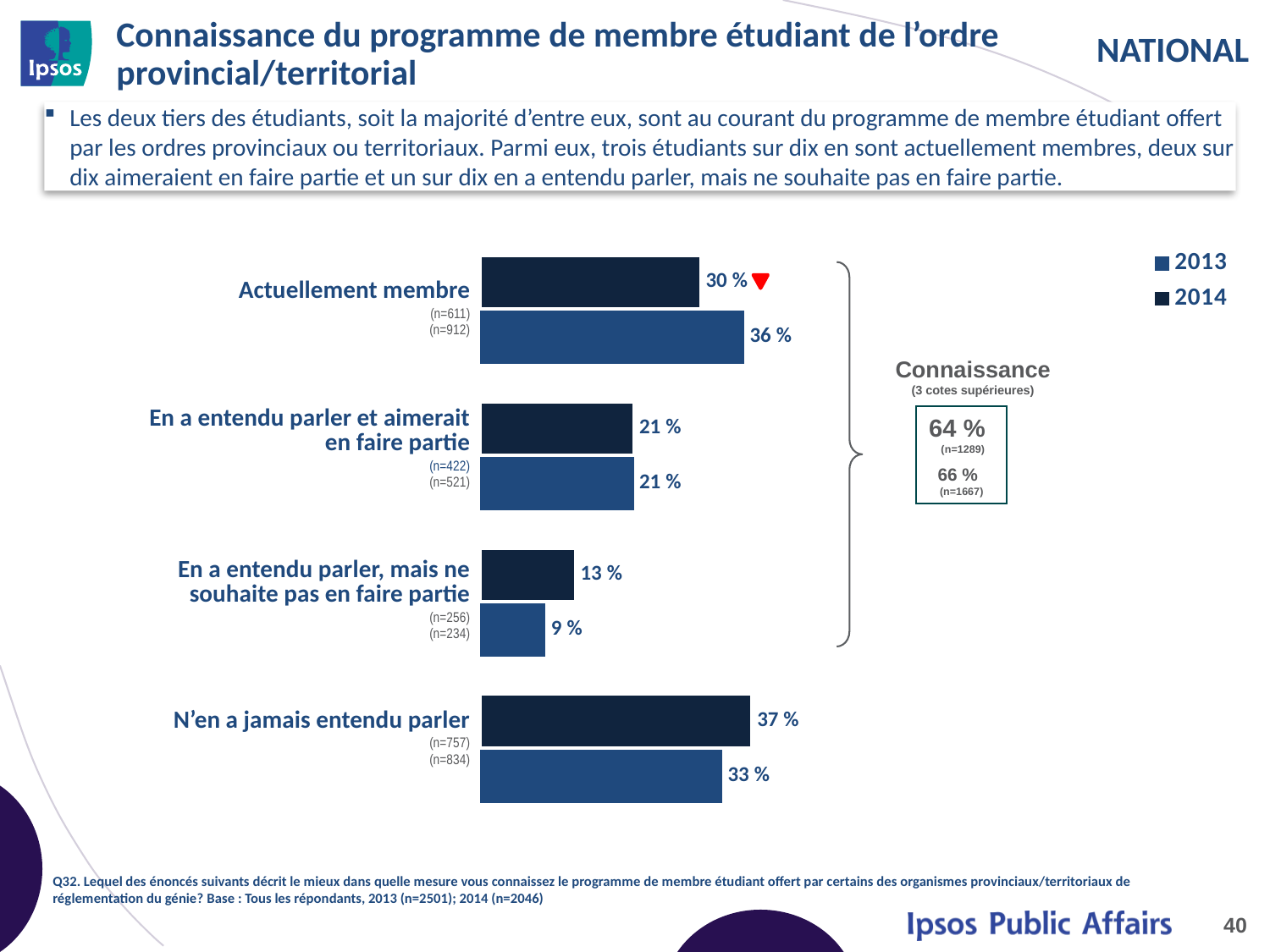
Which years are listed in the chart legend? 2013 and 2014 What two percentages are shown in the 'Connaissance (3 cotes supérieures)' box? 64 % and 66 % Among the lighter blue bars, which category has the lowest value? En a entendu parler, mais ne souhaite pas en faire partie How many categories are plotted in the bar chart? 4 For 'N'en a jamais entendu parler', which bar is larger, the darker navy bar or the lighter blue bar? The darker navy bar (37 %) How many series does the chart legend list? 2 What is the difference between the two bars for 'Actuellement membre' (36 % and 30 %)? 6 percentage points What value is shown on the lighter blue bar for 'En a entendu parler, mais ne souhaite pas en faire partie'? 9 % For 'Actuellement membre', what value is shown on the lighter blue bar? 36 % What type of chart is shown on the slide? Bar chart What value is shown on the darker (navy) bar for 'N'en a jamais entendu parler'? 37 % For 'Actuellement membre', what value is shown on the darker (navy) bar? 30 %